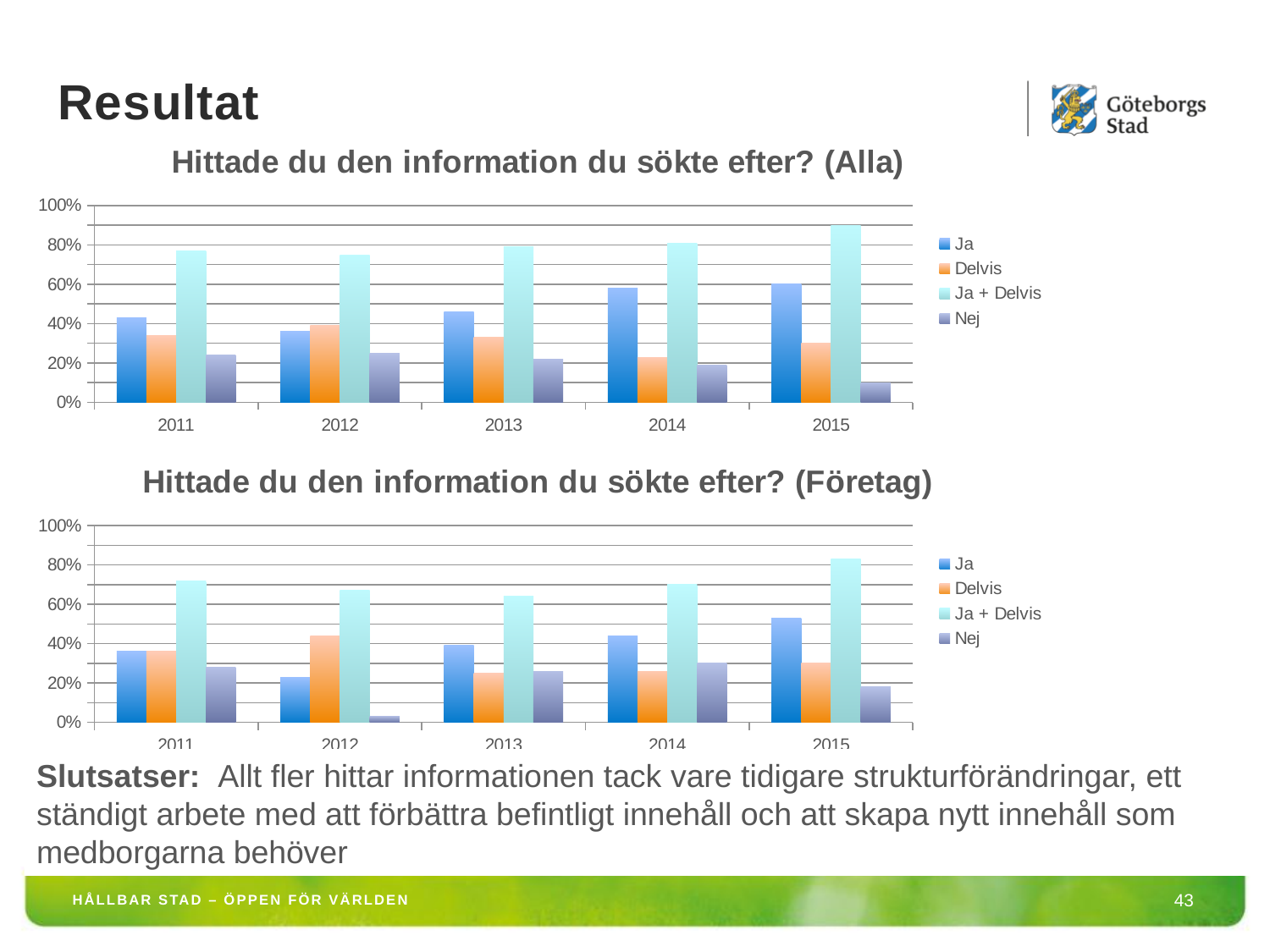
What kind of chart is the top chart titled 'Hittade du den information du sökte efter? (Alla)'? bar chart In the top chart (Alla), which year has the highest 'Ja + Delvis' value? 2015 In the top chart (Alla), is the 'Nej' value for 2015 greater or less than 20%? less In the top chart (Alla), which year has the lowest 'Nej' value? 2015 How many series does the legend of the top chart (Alla) list? 4 In the top chart (Alla), does the 'Ja' value rise or fall from 2012 to 2015? rise In the bottom chart (Företag), is the 'Ja + Delvis' value for 2015 greater or less than 60%? greater In the bottom chart (Företag), which year has the highest 'Ja' value? 2015 In the bottom chart (Företag), which year has the lowest 'Nej' value? 2012 In the bottom chart (Företag), which is larger for 2012: 'Ja' or 'Delvis'? Delvis In the top chart (Alla), is the 'Ja' value for 2015 greater or less than 40%? greater How many years are shown on the x axis of the bottom chart (Företag)? 5